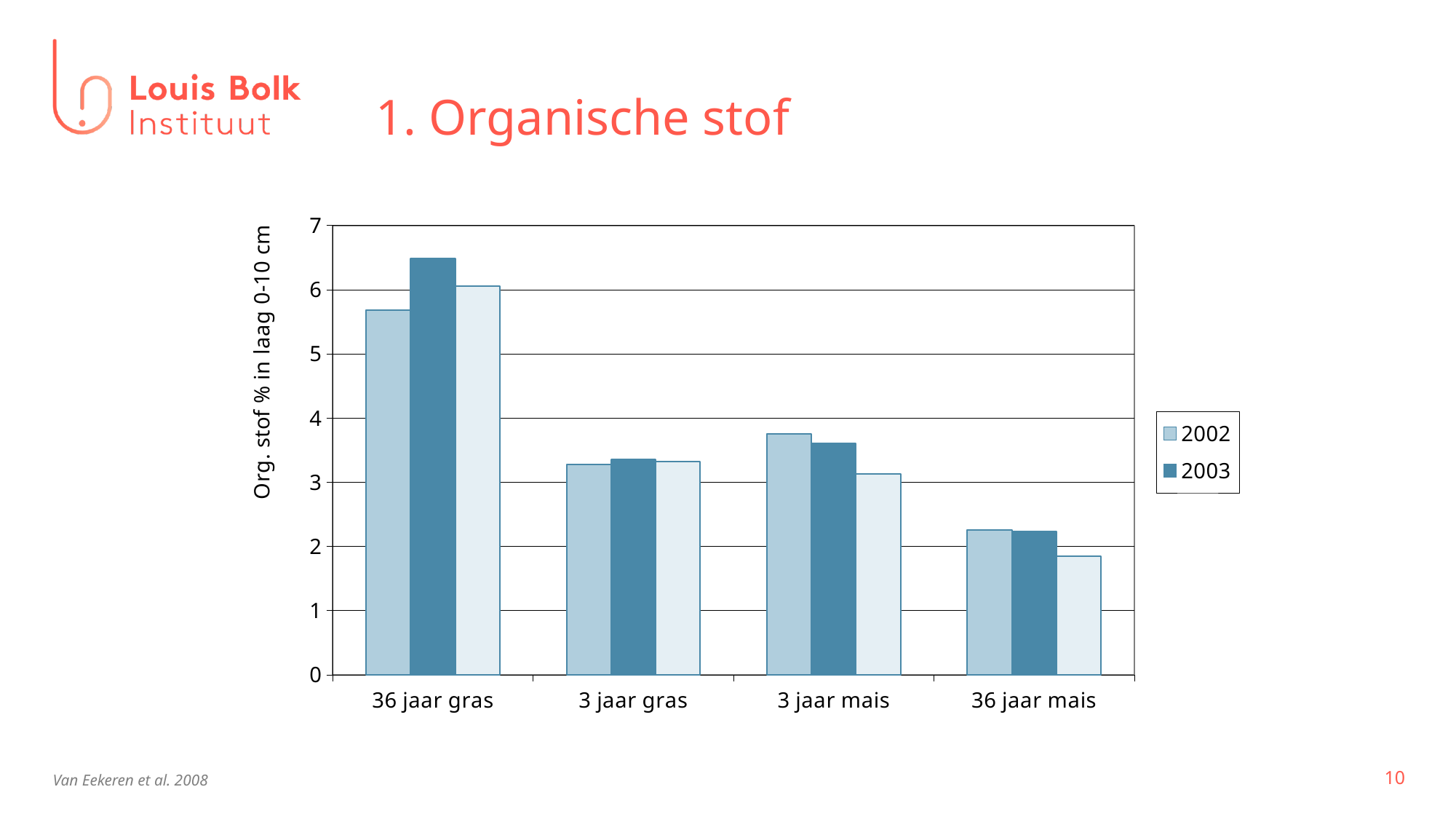
Is the 2003 value for 36 jaar gras greater or less than 6? greater Which category has the highest value for the 2003 series? 36 jaar gras What kind of chart is shown on the slide? bar chart For 36 jaar gras, which series has the larger value, 2002 or 2003? 2003 For 3 jaar mais, which series has the larger value, 2002 or 2003? 2002 How many categories are shown on the x axis of the chart? 4 Which category has the lowest value for the 2002 series? 36 jaar mais Is the 2002 value for 3 jaar mais greater or less than 4? less Is the 2003 value for 3 jaar gras greater or less than 3? greater How many series does the chart's legend list? 2 Which category has the lowest value for the 2003 series? 36 jaar mais What is the label on the y axis of the chart? Org. stof % in laag 0-10 cm